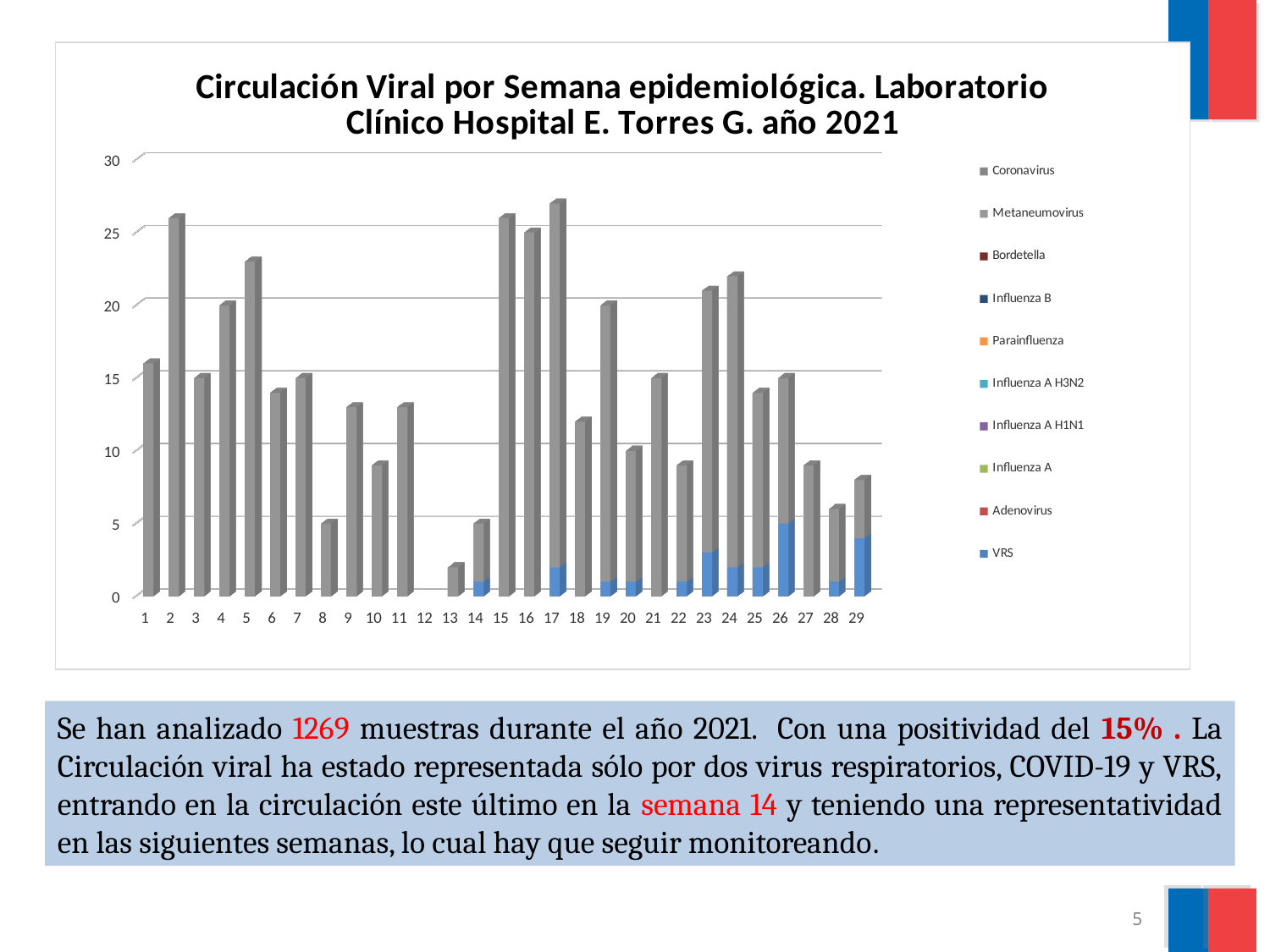
Is the total value for week 4 greater or less than 15? greater Which has a taller bar, week 2 or week 8? week 2 How many series does the legend list? 10 Which series is shown in blue at the bottom of the stacked bars? VRS Is the total value for week 13 greater or less than 5? less How many epidemiological weeks are shown on the x axis? 29 Is the total value for week 8 greater or less than 10? less Which has a taller bar, week 15 or week 13? week 15 What kind of chart is shown on the slide? bar chart What is the title of the chart? Circulación Viral por Semana epidemiológica. Laboratorio Clínico Hospital E. Torres G. año 2021